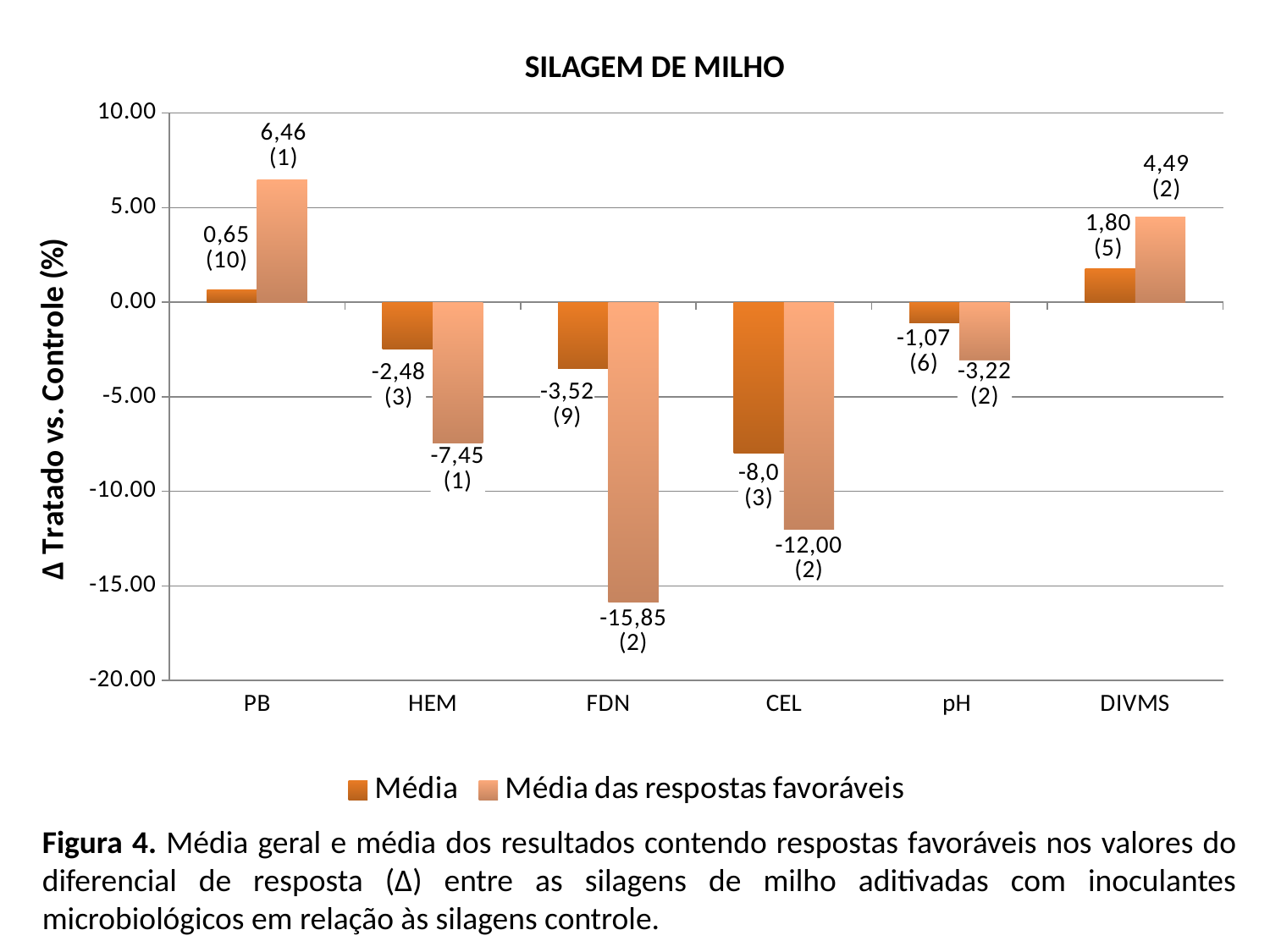
What is the value of the Média series for CEL? -8,0 Which category has the highest value in the Média series? DIVMS Which is larger, the Média value for HEM or the Média value for pH? pH What is the difference between the Média das respostas favoráveis value and the Média value for PB? 5,81 Which category has the lowest value in the Média das respostas favoráveis series? FDN What is the value of the Média das respostas favoráveis series for DIVMS? 4,49 How many series does the legend list? 2 Is the Média das respostas favoráveis value for CEL greater or less than -10.00? less What kind of chart is shown on the slide? bar chart How many categories are shown on the x axis? 6 What is the value of the Média series for PB? 0,65 What is the value of the Média das respostas favoráveis series for FDN? -15,85